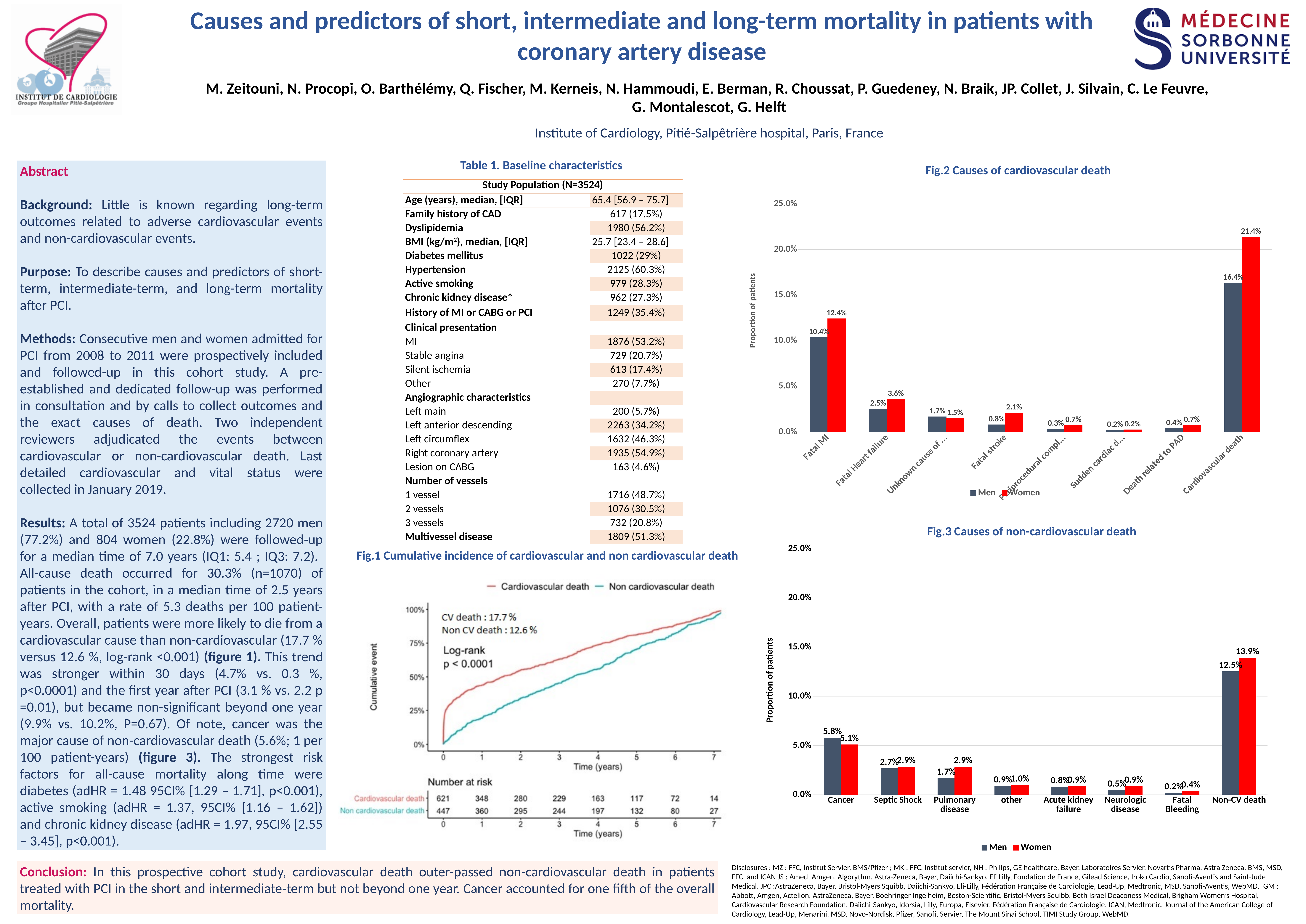
In Fig.3 Causes of non-cardiovascular death, which category has the highest value for Women? Non-CV death In Fig.3 Causes of non-cardiovascular death, what is the value for Men for Cancer? 5.8% What kind of chart is Fig.3 Causes of non-cardiovascular death? Bar chart In Fig.3 Causes of non-cardiovascular death, which is larger for Pulmonary disease, Men or Women? Women In Fig.2 Causes of cardiovascular death, what is the value for Women for Fatal MI? 12.4% In Fig.3 Causes of non-cardiovascular death, which category has the lowest value for Men? Fatal Bleeding In Fig.3 Causes of non-cardiovascular death, how many categories are shown on the x axis? 8 In Fig.2 Causes of cardiovascular death, is the value for Women for Cardiovascular death greater or less than 20.0%? greater In Fig.1 Cumulative incidence of cardiovascular and non cardiovascular death, what is the CV death rate printed on the chart? 17.7 % In Fig.2 Causes of cardiovascular death, how many series does the legend list? 2 In Fig.2 Causes of cardiovascular death, what is the value for Men for Cardiovascular death? 16.4% In Fig.2 Causes of cardiovascular death, what is the difference between Women and Men for Fatal stroke? 1.3%